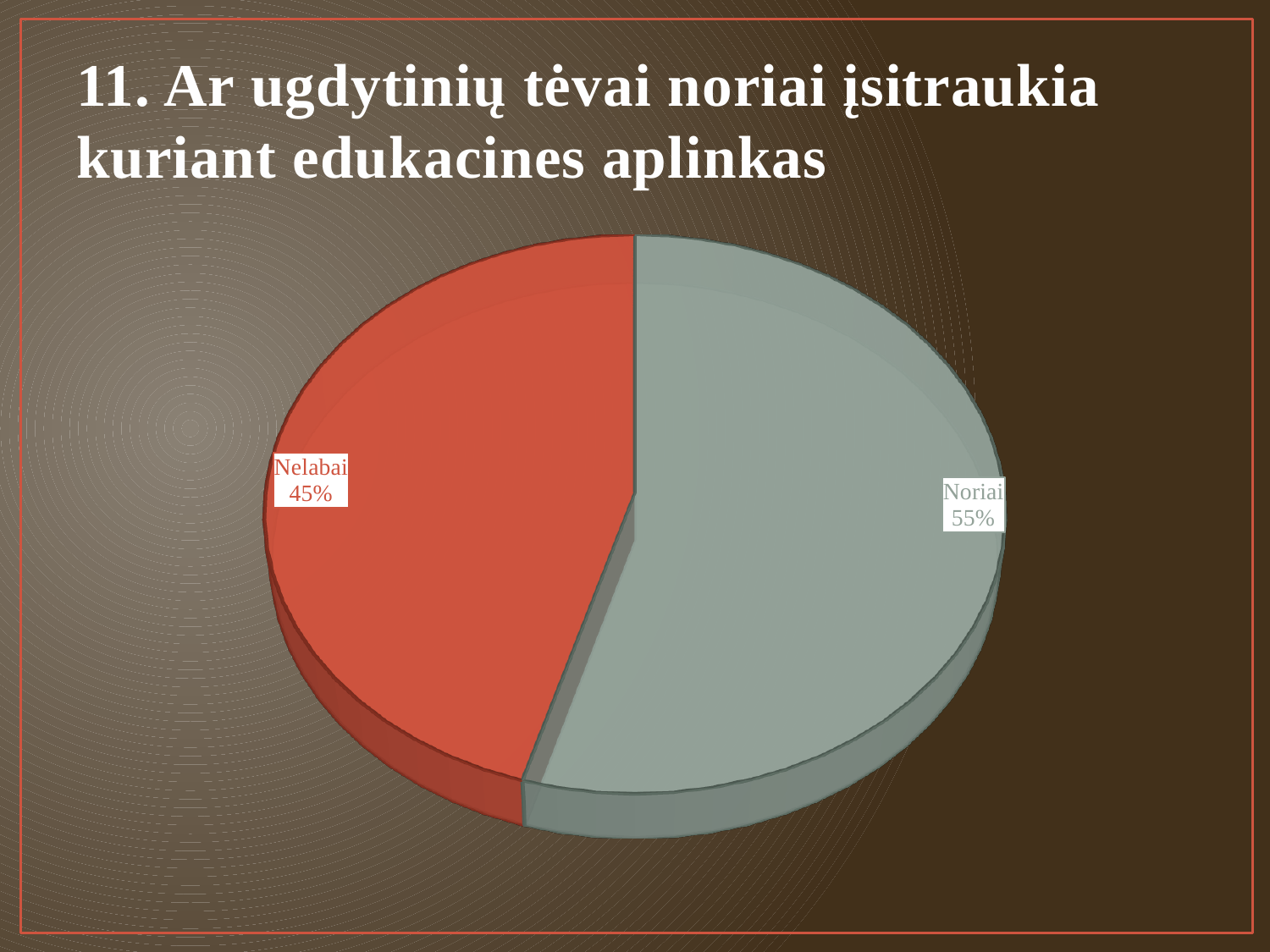
What is the difference in percentage points between the "Noriai" and "Nelabai" slices? 10% What kind of chart is shown on the slide? pie chart Is the value for "Noriai" greater or less than 50%? greater Which slice of the pie is the largest? Noriai What share of the pie does the "Noriai" slice represent? 55% Is the value for "Nelabai" greater or less than 50%? less Which is larger, the "Noriai" slice or the "Nelabai" slice? Noriai How many slices does the pie chart have? 2 What share of the pie does the "Nelabai" slice represent? 45% What is the title of the slide containing the pie chart? 11. Ar ugdytinių tėvai noriai įsitraukia kuriant edukacines aplinkas Which slice of the pie is the smallest? Nelabai What colour is the "Nelabai" slice of the pie? red